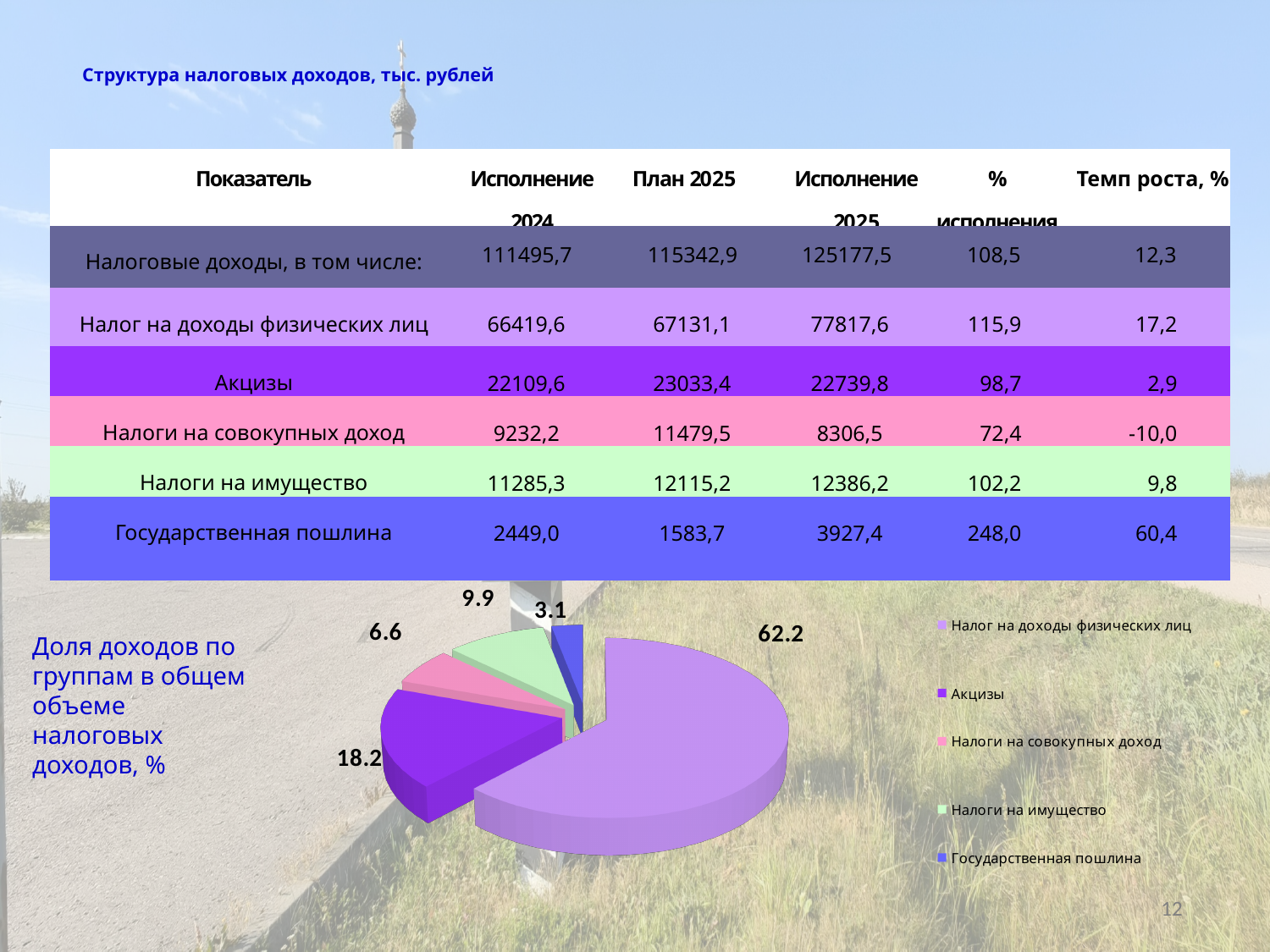
Which category has the smallest slice in the pie chart? Государственная пошлина How many slices does the pie chart have? 5 What type of chart is shown at the bottom of the slide? pie chart In the pie chart, what is the share for Налоги на имущество? 9.9 In the pie chart, what is the share for Акцизы? 18.2 In the pie chart, which is larger: Налоги на имущество or Налоги на совокупных доход? Налоги на имущество In the pie chart, what is the share for Налог на доходы физических лиц? 62.2 In the pie chart, what is the share for Налоги на совокупных доход? 6.6 What colour is the slice for Акцизы in the pie chart? purple In the pie chart, what is the share for Государственная пошлина? 3.1 Which category has the largest slice in the pie chart? Налог на доходы физических лиц In the pie chart, what is the difference between the shares of Акцизы and Налоги на имущество? 8.3